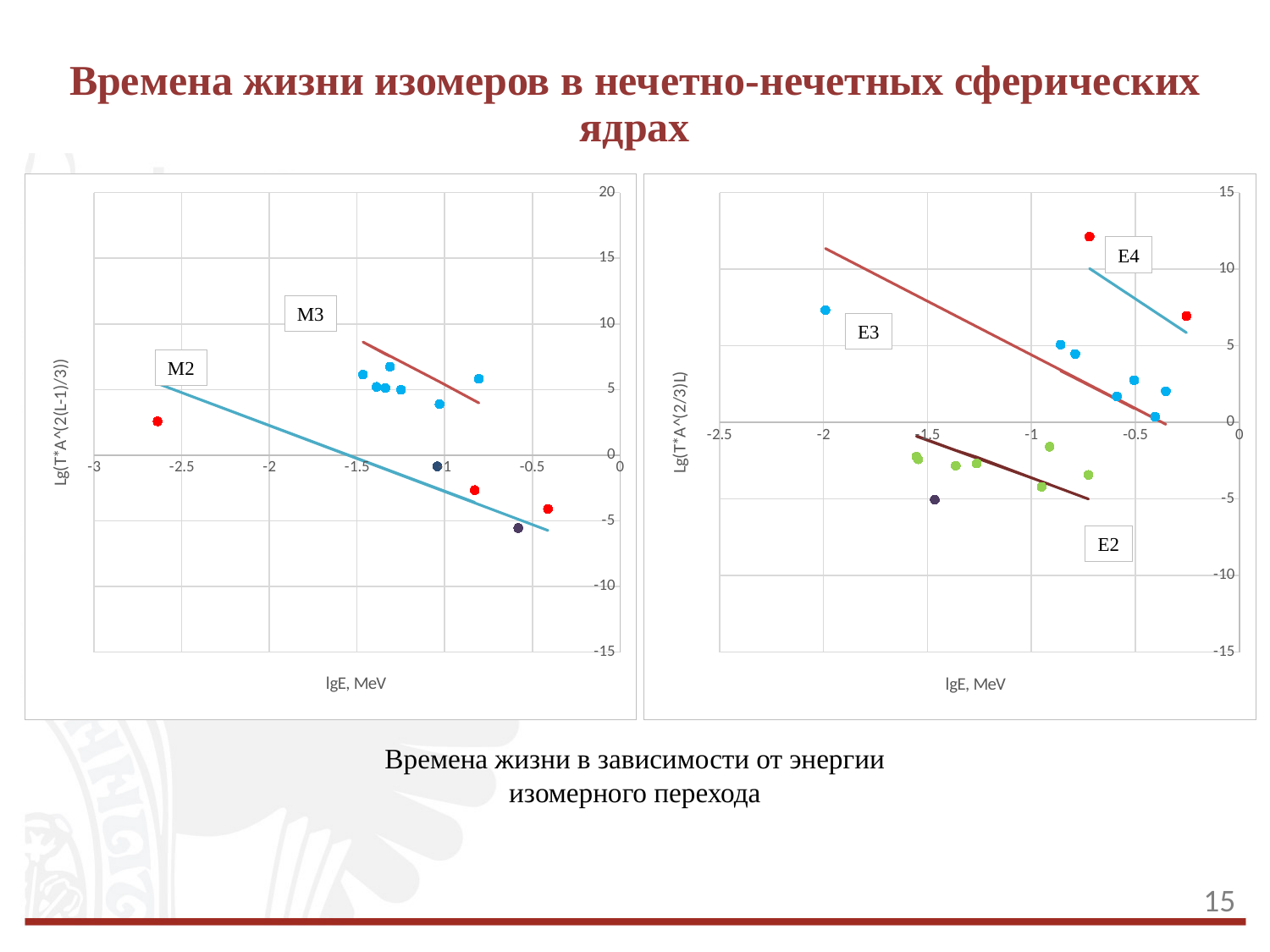
In the left chart, is the y value of the red point near lgE = -2.6 greater or less than 0? greater How many fitted lines are labelled in the left chart? 2 In the left chart, do the fitted lines labelled M2 and M3 rise or fall as lgE increases? fall In the left chart, is the y value of the red point near lgE = -0.4 greater or less than 0? less What is the y-axis label of the right chart? Lg(T*A^(2/3)L) What kind of chart is the right chart on the slide? scatter chart What kind of chart is the left chart on the slide? scatter chart In the right chart, do the fitted lines labelled E2, E3 and E4 rise or fall as lgE increases? fall In the right chart, is the y value of the blue point near lgE = -2 greater or less than 5? greater How many fitted lines are labelled in the right chart? 3 What is the x-axis label of the left chart? lgE, MeV